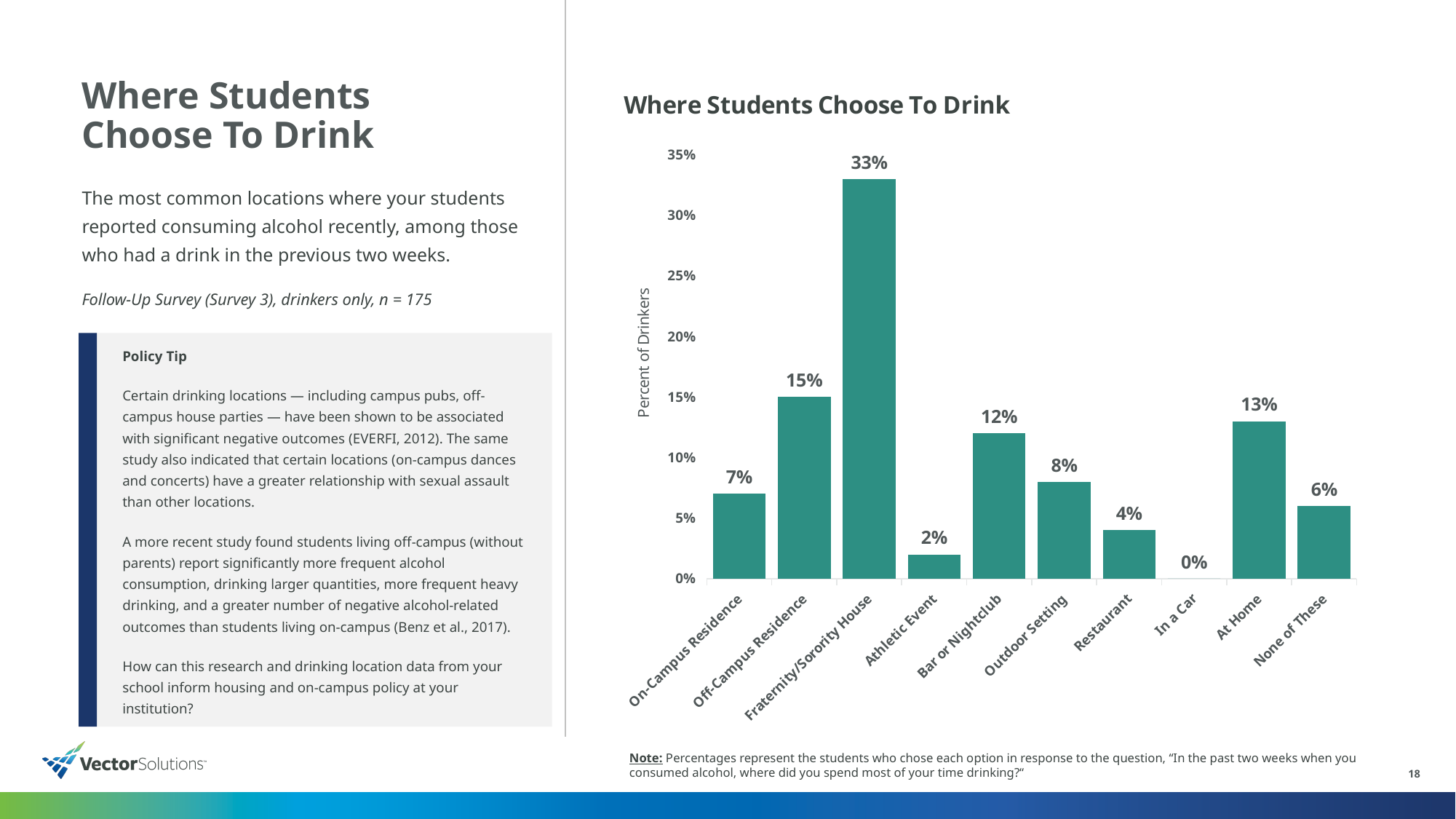
Which location has the lowest percentage of drinkers? In a Car What is the label of the y axis? Percent of Drinkers What percentage of drinkers chose Fraternity/Sorority House? 33% Is the value for Fraternity/Sorority House greater or less than 30%? greater How many location categories are shown on the x axis? 10 What percentage is shown for At Home? 13% Which location has the highest percentage of drinkers? Fraternity/Sorority House Which is larger, the value for Outdoor Setting or the value for Restaurant? Outdoor Setting What is the title of the chart? Where Students Choose To Drink What is the difference between Off-Campus Residence and On-Campus Residence? 8% What type of chart is shown on the slide? bar chart What is the value for Bar or Nightclub? 12%